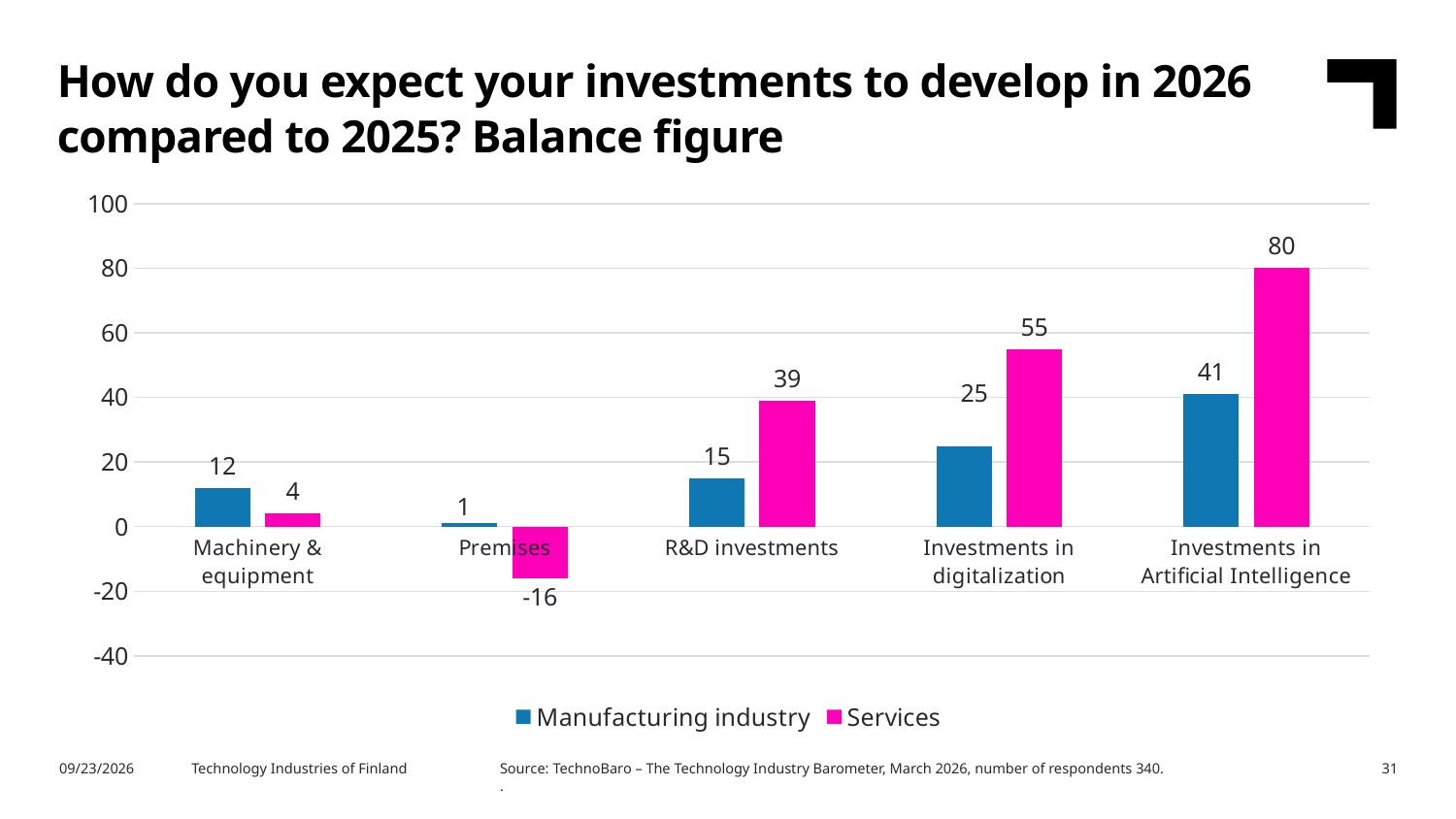
For Machinery & equipment, which series has the larger value, Manufacturing industry or Services? Manufacturing industry What is the difference between the Services and Manufacturing industry values for R&D investments? 24 What kind of chart is shown on the slide? Bar chart Which category has the lowest Manufacturing industry value? Premises What is the Manufacturing industry value for Investments in digitalization? 25 What is the Services value for Investments in Artificial Intelligence? 80 How many series does the legend list? 2 What is the difference between the Services values for Investments in Artificial Intelligence and Investments in digitalization? 25 How many categories are shown on the x axis? 5 Which category has the highest Services value? Investments in Artificial Intelligence What is the Services value for Premises? -16 Which colour represents the Services series in the legend? Magenta (pink)